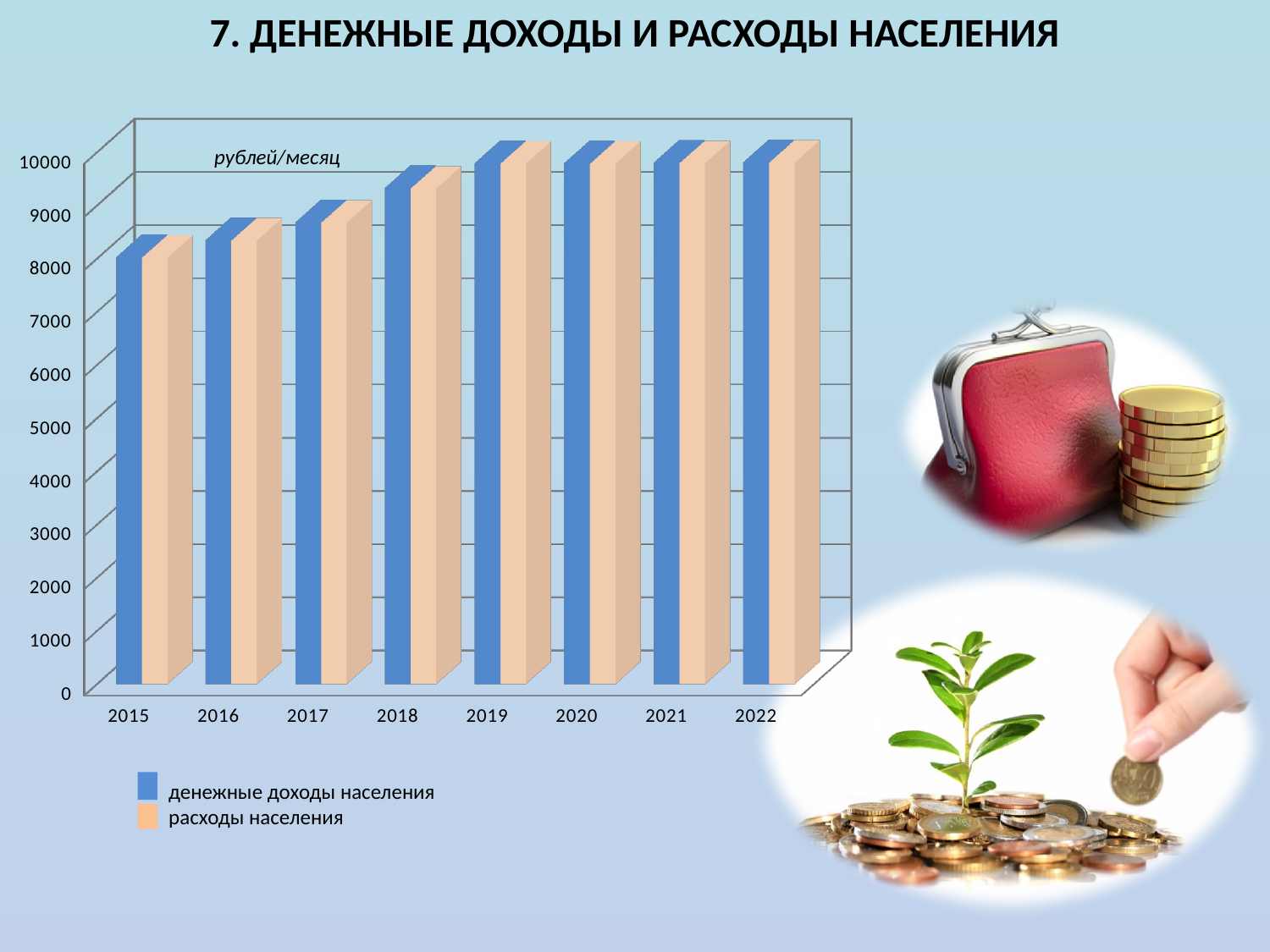
Is the value for расходы населения in 2016 greater or less than 8000? greater How many years are shown on the x axis? 8 Is the value for денежные доходы населения in 2015 greater or less than 9000? less Which is larger: денежные доходы населения in 2018 or in 2015? 2018 What unit is shown on the chart for the values? рублей/месяц Which year has the lowest value for денежные доходы населения? 2015 Is the value for денежные доходы населения in 2015 greater or less than 7000? greater Which series is shown in blue? денежные доходы населения Do the values for денежные доходы населения rise or fall from 2015 to 2022? rise What kind of chart is shown on the slide? bar chart How many series does the legend list? 2